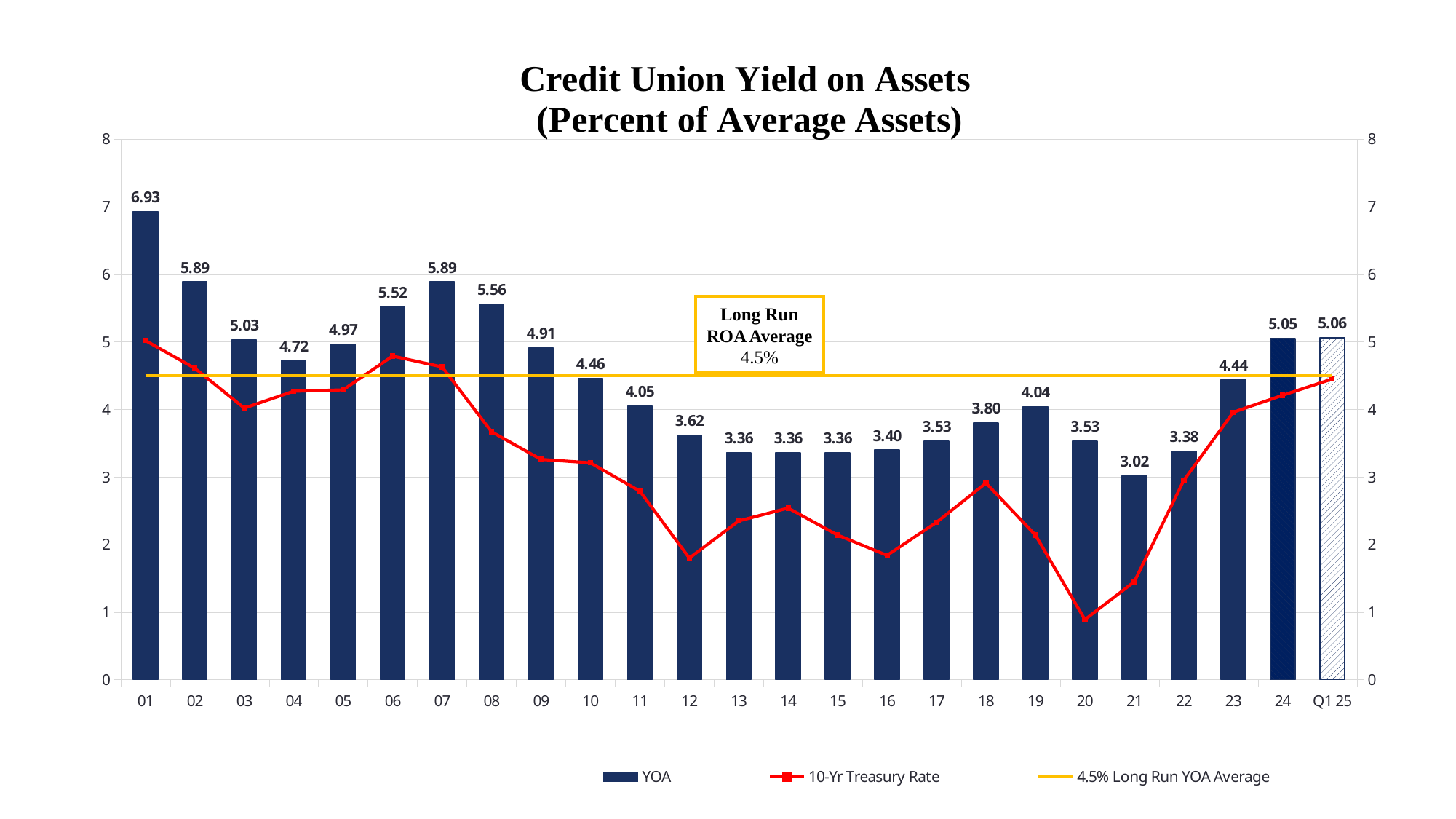
What value does the 4.5% Long Run YOA Average line represent? 4.5% How many categories are shown on the x axis? 25 What is the YOA value for 01? 6.93 Which is larger, the YOA value for 12 or the YOA value for 18? 18 Which category has the lowest YOA value? 21 How many series does the legend list? 3 What is the YOA value for 21? 3.02 Is the 10-Yr Treasury Rate for 20 greater or less than 1? less Which category has the highest YOA value? 01 What is the YOA value for Q1 25? 5.06 Is the 10-Yr Treasury Rate for 01 greater or less than 4? greater What is the difference between the YOA values for 24 and 23? 0.61